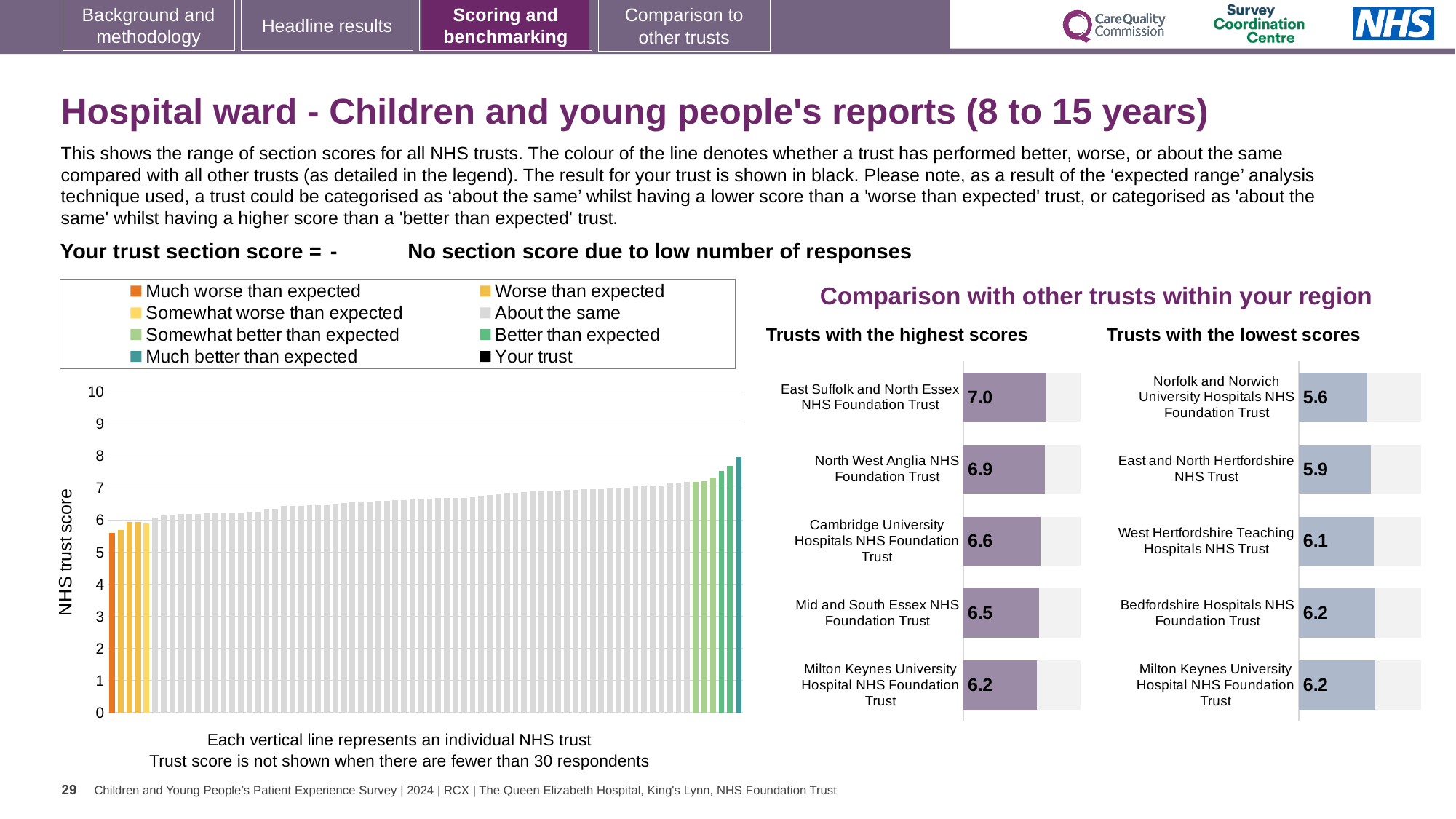
In the 'Trusts with the lowest scores' chart, what is the score for Norfolk and Norwich University Hospitals NHS Foundation Trust? 5.6 In the 'Trusts with the highest scores' chart, what is the score for East Suffolk and North Essex NHS Foundation Trust? 7.0 In the 'Trusts with the lowest scores' chart, what is the score for West Hertfordshire Teaching Hospitals NHS Trust? 6.1 In the 'Trusts with the lowest scores' chart, which trust has the lowest score? Norfolk and Norwich University Hospitals NHS Foundation Trust In the 'Trusts with the highest scores' chart, what is the difference between the scores of East Suffolk and North Essex NHS Foundation Trust and Milton Keynes University Hospital NHS Foundation Trust? 0.8 In the 'Trusts with the highest scores' chart, what is the score for Cambridge University Hospitals NHS Foundation Trust? 6.6 In the 'Trusts with the lowest scores' chart, what is the difference between the scores of Bedfordshire Hospitals NHS Foundation Trust and Norfolk and Norwich University Hospitals NHS Foundation Trust? 0.6 How many entries does the legend of the NHS trust score chart on the left list? 8 How many trusts are listed in the 'Trusts with the lowest scores' chart? 5 In the NHS trust score chart on the left, is the value of the lowest (orange) bar greater or less than 6? less In the 'Trusts with the highest scores' chart, which has a higher score: North West Anglia NHS Foundation Trust or Mid and South Essex NHS Foundation Trust? North West Anglia NHS Foundation Trust In the 'Trusts with the highest scores' chart, which trust has the highest score? East Suffolk and North Essex NHS Foundation Trust